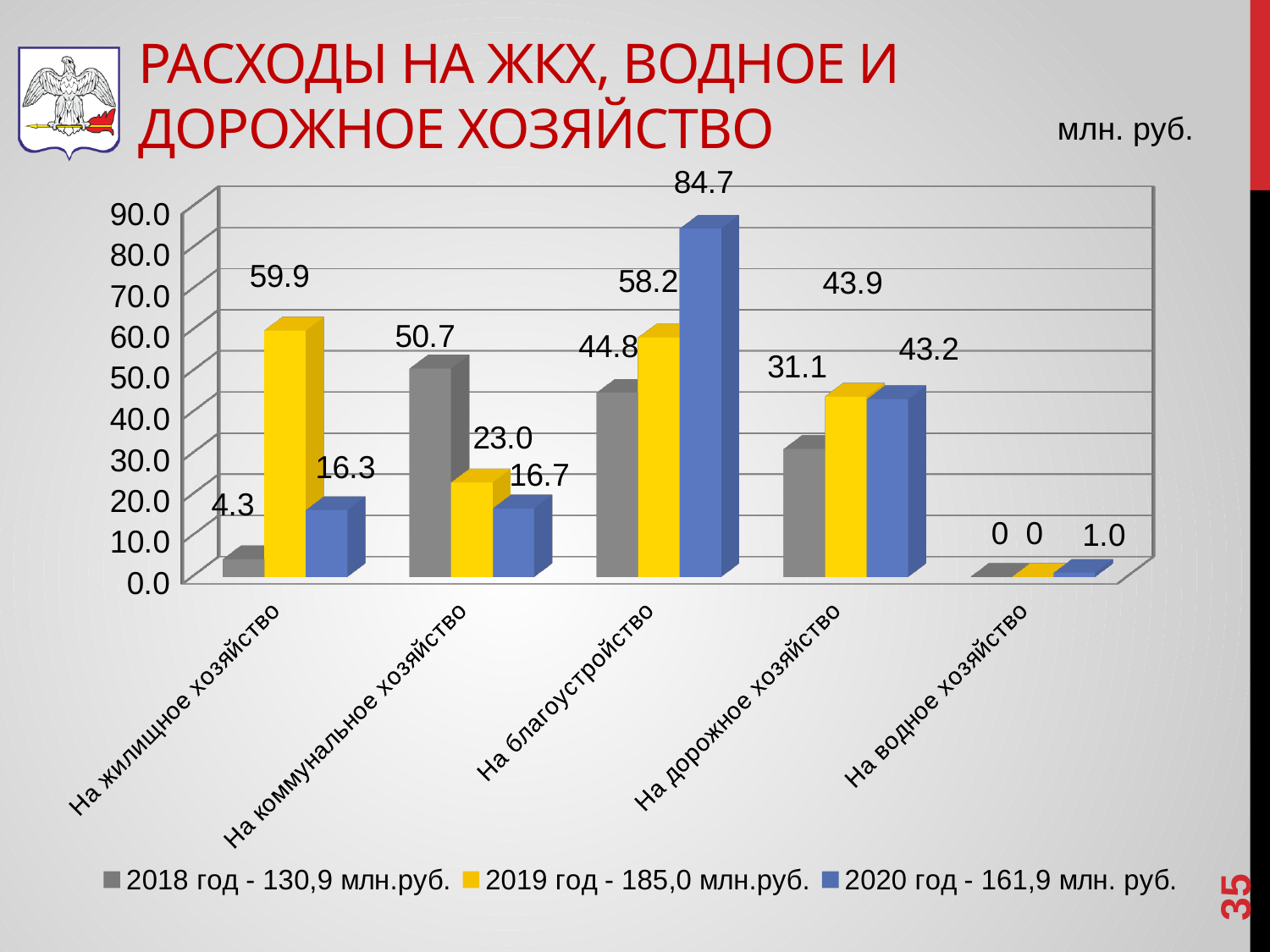
How many series does the legend list? 3 How many categories are shown on the x axis? 5 What is the difference between the 2019 год and 2018 год values for На жилищное хозяйство? 55.6 What is the value for 2020 год for На водное хозяйство? 1.0 What is the value for 2020 год for На благоустройство? 84.7 What is the value for 2018 год for На коммунальное хозяйство? 50.7 What is the value for 2019 год for На жилищное хозяйство? 59.9 Which category has the lowest value for 2018 год? На водное хозяйство What total is given in the legend for 2019 год? 185,0 млн.руб. What kind of chart is shown on the slide? Bar chart Which category has the highest value for 2020 год? На благоустройство Which is larger for На коммунальное хозяйство: the 2018 год value or the 2019 год value? 2018 год